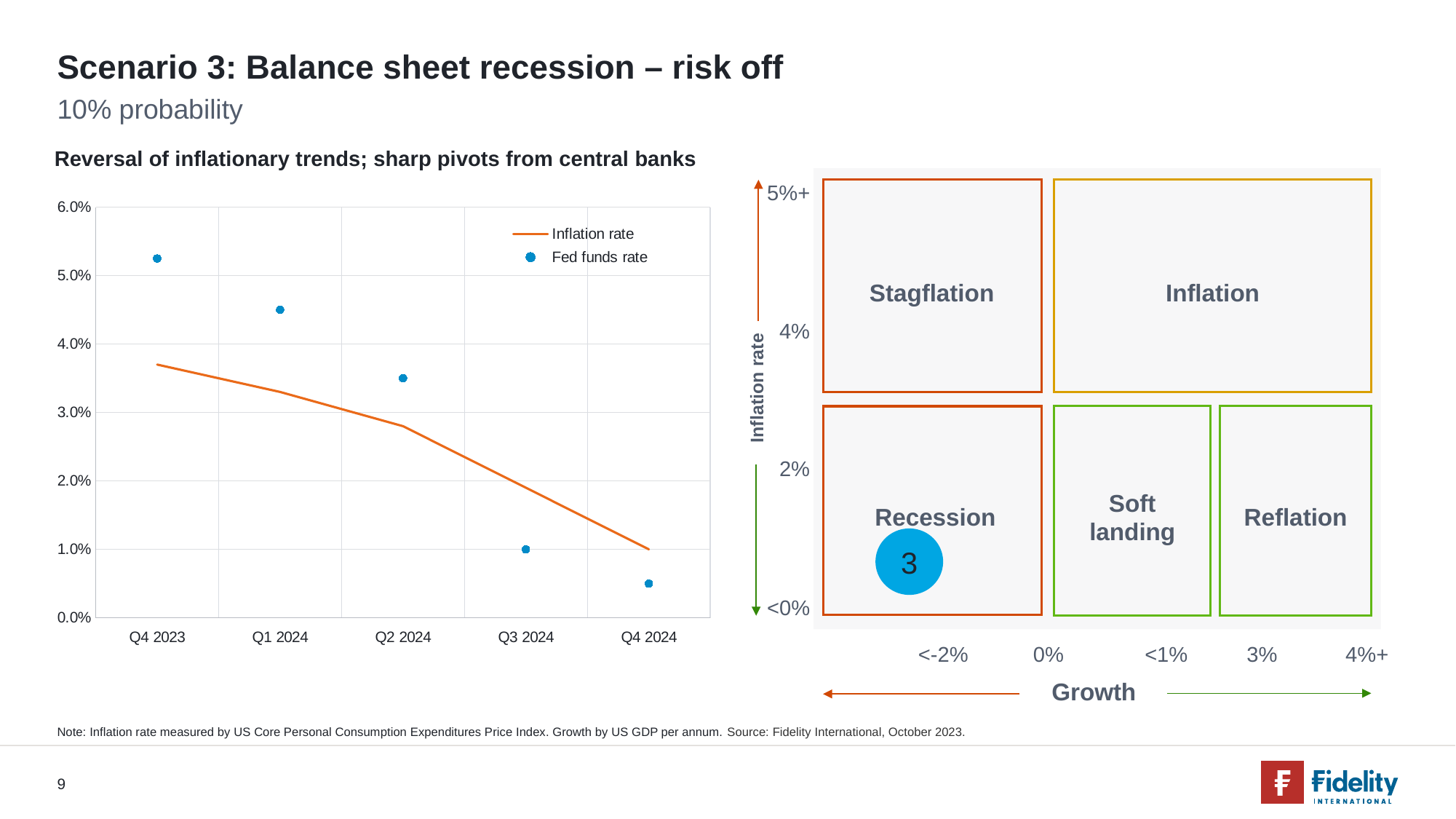
In the left chart, is the Fed funds rate for Q1 2024 greater or less than 4.0%? greater In the left chart, is the inflation rate for Q1 2024 greater or less than 3.0%? greater How many quarters are shown on the x axis of the left chart? 5 In the left chart, which is larger in Q4 2023: the inflation rate or the Fed funds rate? Fed funds rate What are the two legend entries of the left chart? Inflation rate and Fed funds rate In the left chart, does the inflation rate rise or fall from Q4 2023 to Q4 2024? fall How many series does the legend of the left chart list? 2 In the left chart, is the Fed funds rate for Q4 2023 greater or less than 5.0%? greater In the left chart, which quarter has the lowest Fed funds rate? Q4 2024 In the left chart, which quarter has the highest Fed funds rate? Q4 2023 What kind of chart is shown on the left of the slide? line chart